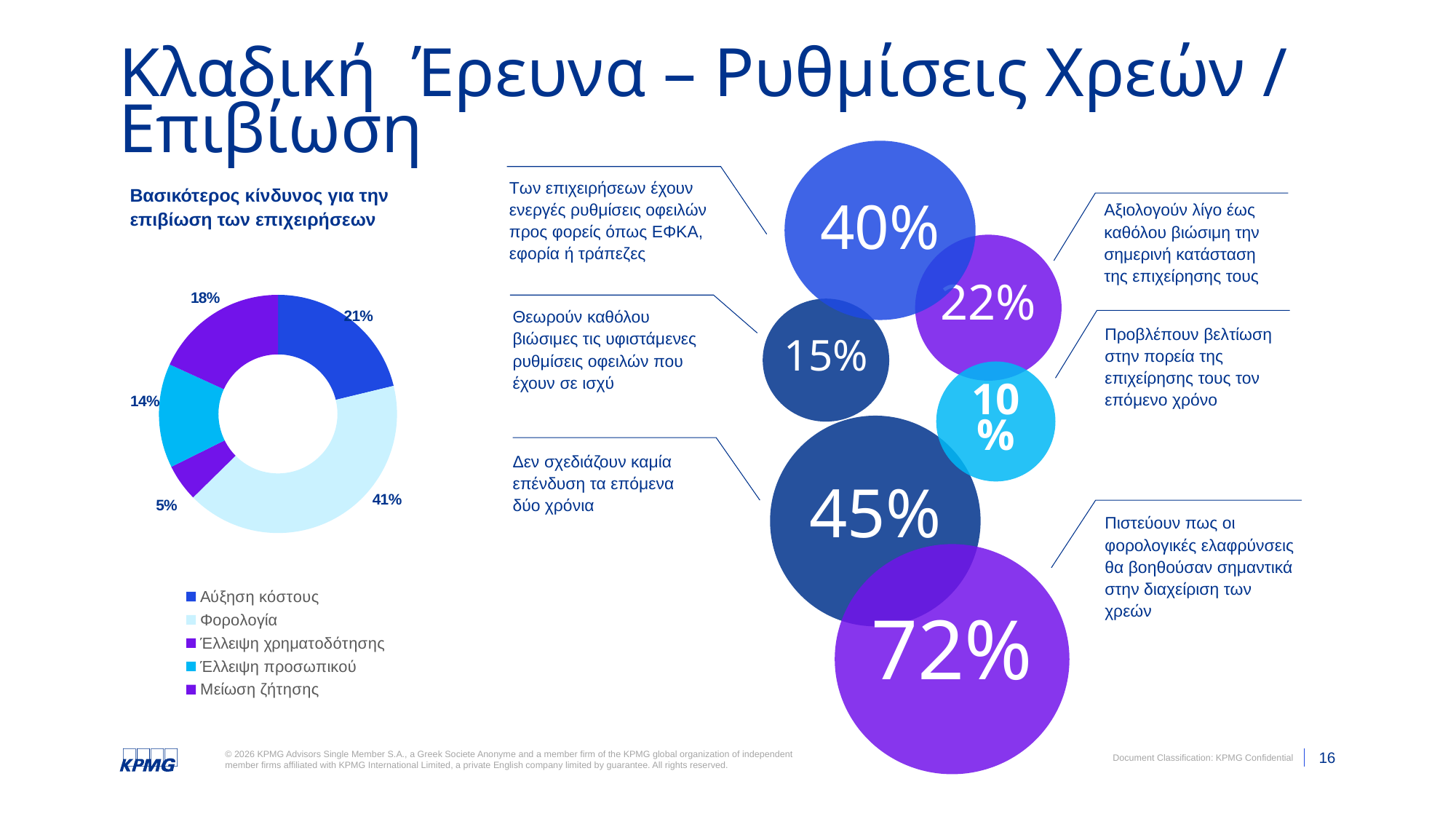
In the doughnut chart, what share is shown for Μείωση ζήτησης? 18% In the doughnut chart, what is the combined share of Έλλειψη χρηματοδότησης and Έλλειψη προσωπικού? 19% In the doughnut chart, what share is shown for Φορολογία? 41% In the doughnut chart, what is the difference between the shares for Φορολογία and Αύξηση κόστους? 20% In the doughnut chart, which category has the largest share? Φορολογία In the doughnut chart, what share is shown for Αύξηση κόστους? 21% In the doughnut chart, what share is shown for Έλλειψη προσωπικού? 14% How many categories does the doughnut chart show? 5 In the doughnut chart, which is larger: the share for Μείωση ζήτησης or the share for Έλλειψη προσωπικού? Μείωση ζήτησης What type of chart is shown on the left of the slide? Doughnut chart In the doughnut chart, which category has the smallest share? Έλλειψη χρηματοδότησης What is the title of the doughnut chart? Βασικότερος κίνδυνος για την επιβίωση των επιχειρήσεων